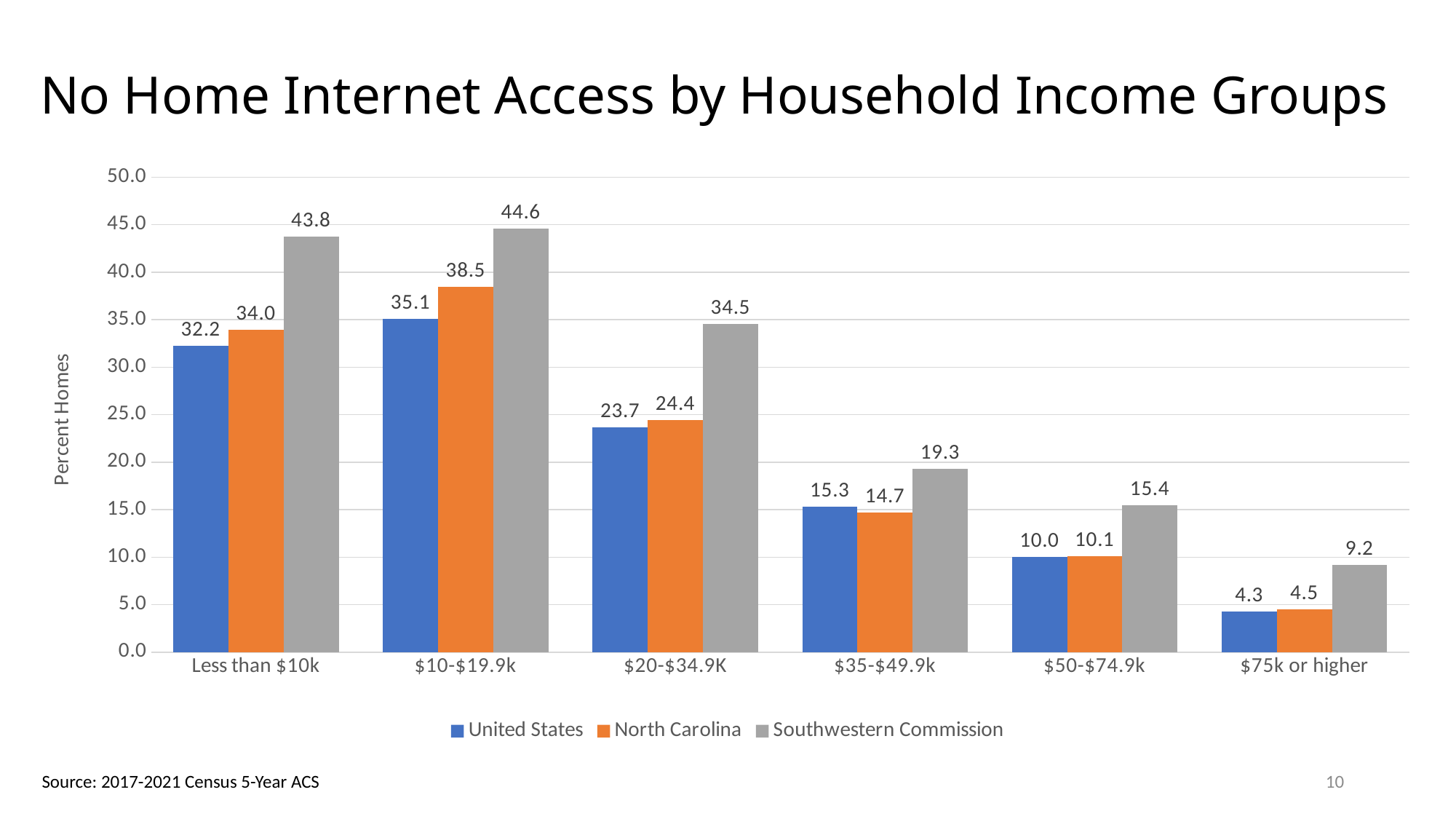
In the $50-$74.9k income group, which is larger: the Southwestern Commission value or the North Carolina value? Southwestern Commission How many series does the legend list? 3 Which income group has the lowest value for United States? $75k or higher What kind of chart is shown on the slide? Bar chart What is the value for North Carolina in the $35-$49.9k income group? 14.7 What is the value for Southwestern Commission in the $10-$19.9k income group? 44.6 What is the value for United States in the Less than $10k income group? 32.2 Which income group has the highest value for Southwestern Commission? $10-$19.9k What is the difference between the Southwestern Commission and United States values in the $20-$34.9K income group? 10.8 Do the Southwestern Commission values rise or fall from the $10-$19.9k group to the $75k or higher group? Fall Is the value for North Carolina in the $10-$19.9k income group greater or less than 35.0? greater How many income groups are shown on the x axis? 6